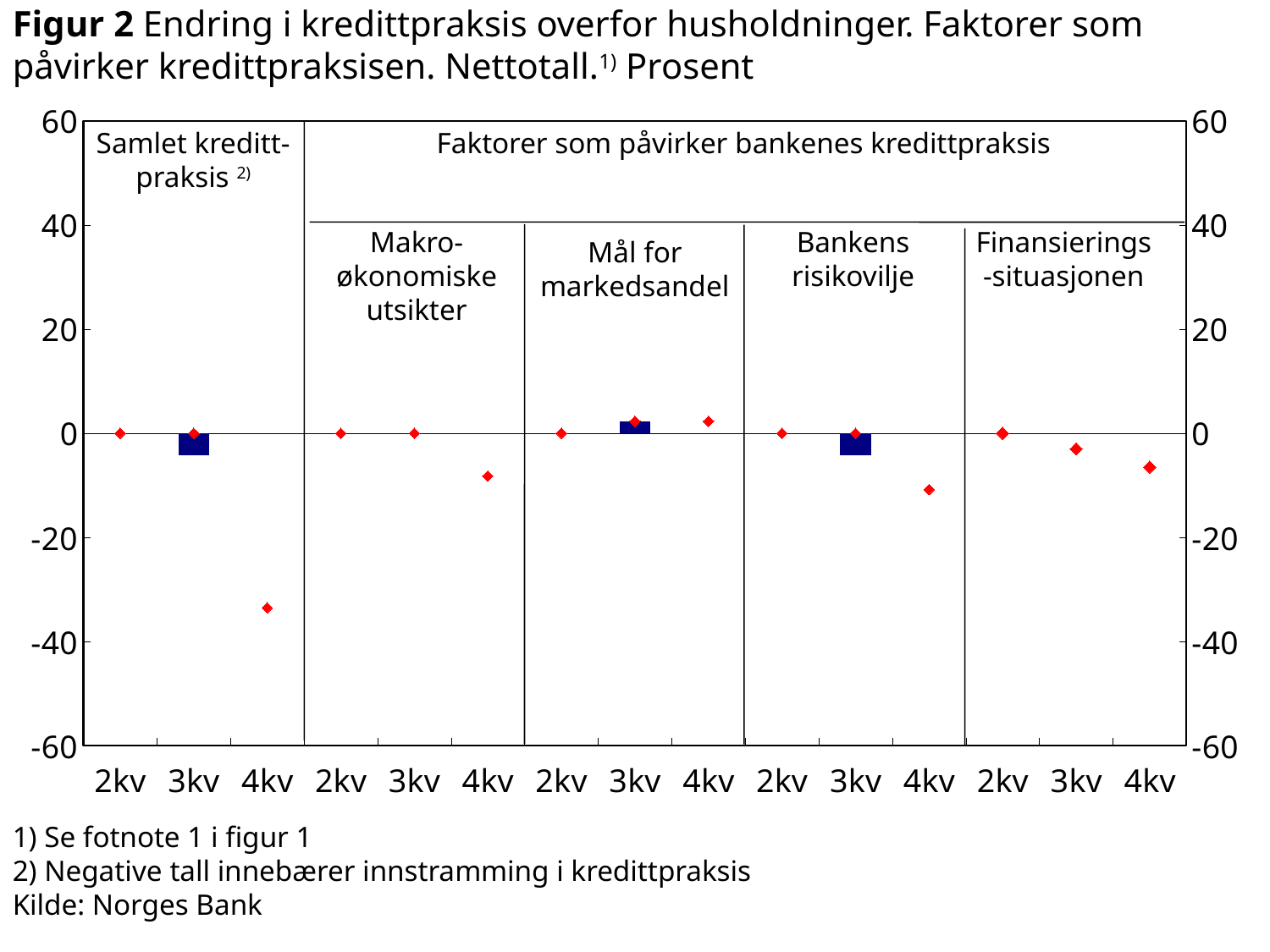
Is the value for 4kv under Makroøkonomiske utsikter greater or less than 0? less Is the value for 4kv under Samlet kredittpraksis greater or less than -20? less Is the value for 4kv under Mål for markedsandel greater or less than 0? greater Which is larger: the 4kv value for Samlet kredittpraksis or the 4kv value for Makroøkonomiske utsikter? Makroøkonomiske utsikter What is the source given for the chart? Norges Bank Which is larger: the 4kv value for Mål for markedsandel or the 4kv value for Finansieringssituasjonen? Mål for markedsandel Do the values under Samlet kredittpraksis rise or fall from 2kv to 4kv? fall How many quarter labels are shown along the x axis in total? 15 Which quarter and panel shows the lowest value on the chart? 4kv, Samlet kredittpraksis How many factors are listed under 'Faktorer som påvirker bankenes kredittpraksis'? 4 Do the values under Finansieringssituasjonen rise or fall from 2kv to 4kv? fall